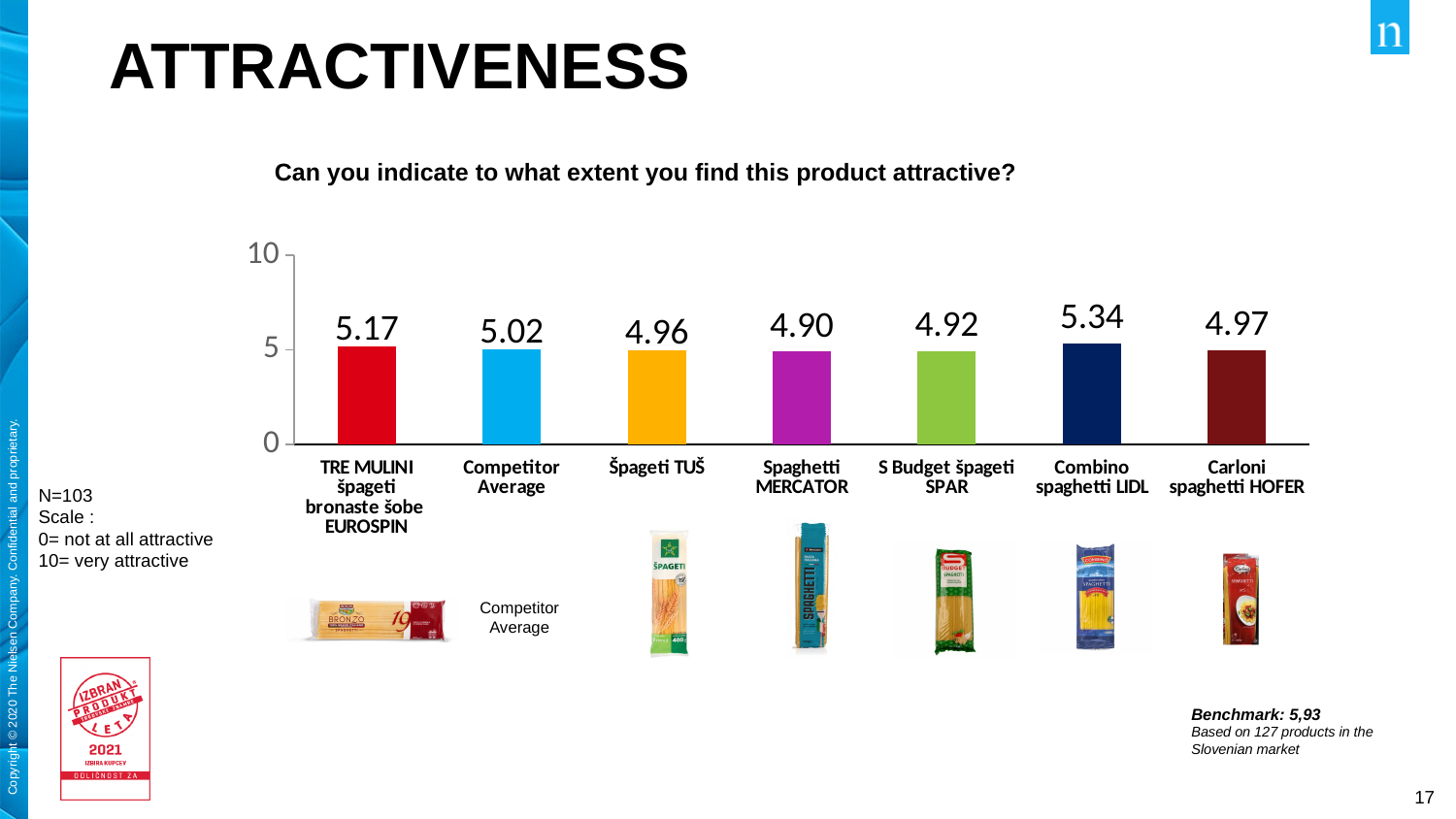
Which has a higher score, Špageti TUŠ or Carloni spaghetti HOFER? Carloni spaghetti HOFER Which product has the highest attractiveness score? Combino spaghetti LIDL What type of chart is shown on the slide? bar chart How many bars are shown in the chart? 7 Which product has the lowest attractiveness score? Spaghetti MERCATOR Is the value for S Budget špageti SPAR greater or less than 5? less What is the attractiveness score for Combino spaghetti LIDL? 5.34 What is the difference between the TRE MULINI špageti bronaste šobe EUROSPIN score and the Competitor Average? 0.15 What is the maximum value shown on the vertical axis? 10 What is the value shown for Competitor Average? 5.02 What is the difference between the scores of Combino spaghetti LIDL and Spaghetti MERCATOR? 0.44 What is the attractiveness score for TRE MULINI špageti bronaste šobe EUROSPIN? 5.17